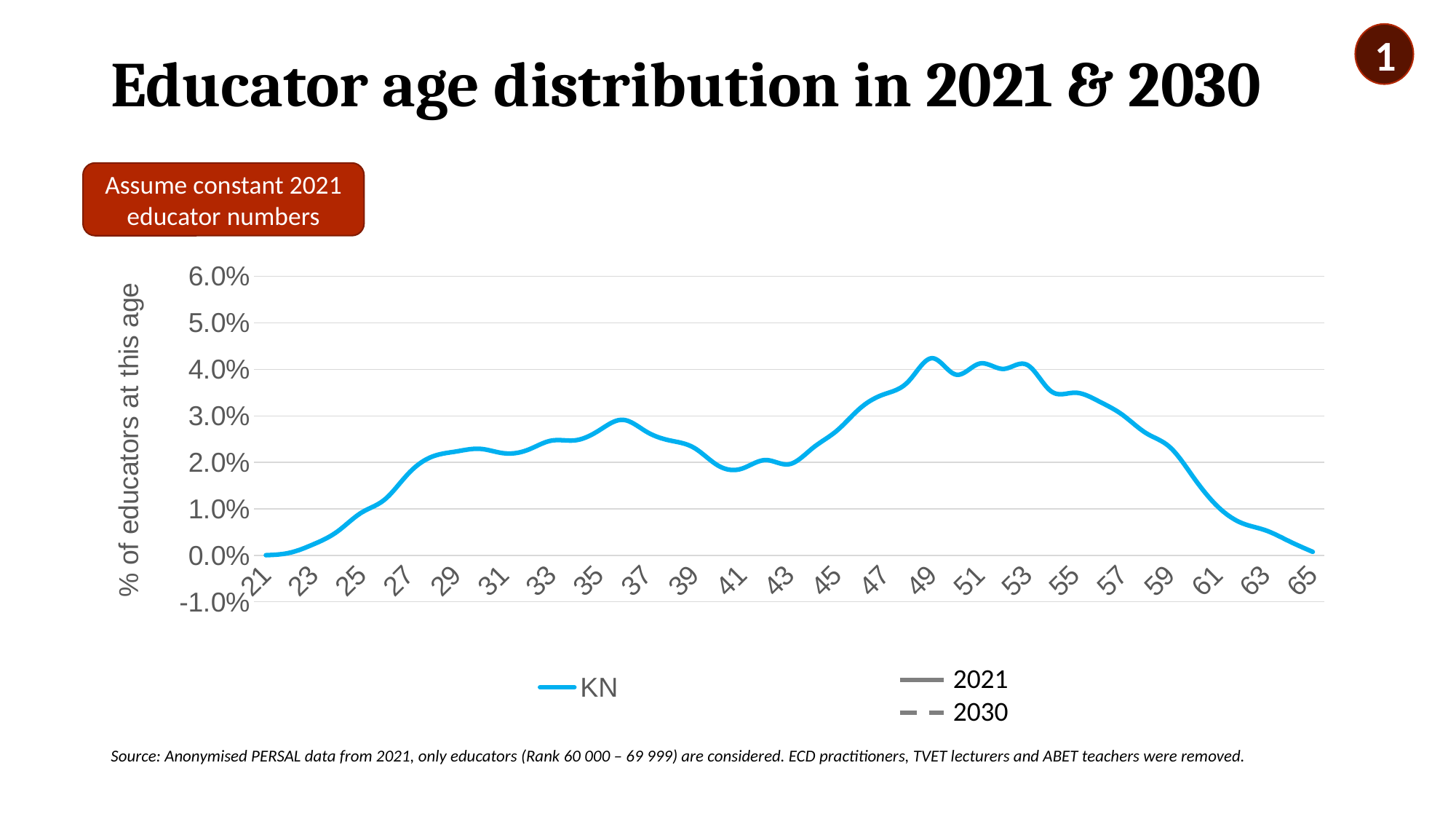
What kind of chart is shown on the slide? line chart Is the value for age 63 greater or less than 1.0%? less Is the value for age 55 greater or less than 3.0%? greater Is the value for age 41 greater or less than 3.0%? less What is the label on the vertical axis of the chart? % of educators at this age What is the name of the series plotted in the chart? KN How many age labels are shown along the x axis? 23 How many series does the chart legend list? 1 Which is larger, the value for age 49 or the value for age 37? age 49 Do the values rise or fall along the x axis from age 55 to age 65? fall Which age has the lowest value on the chart? 21